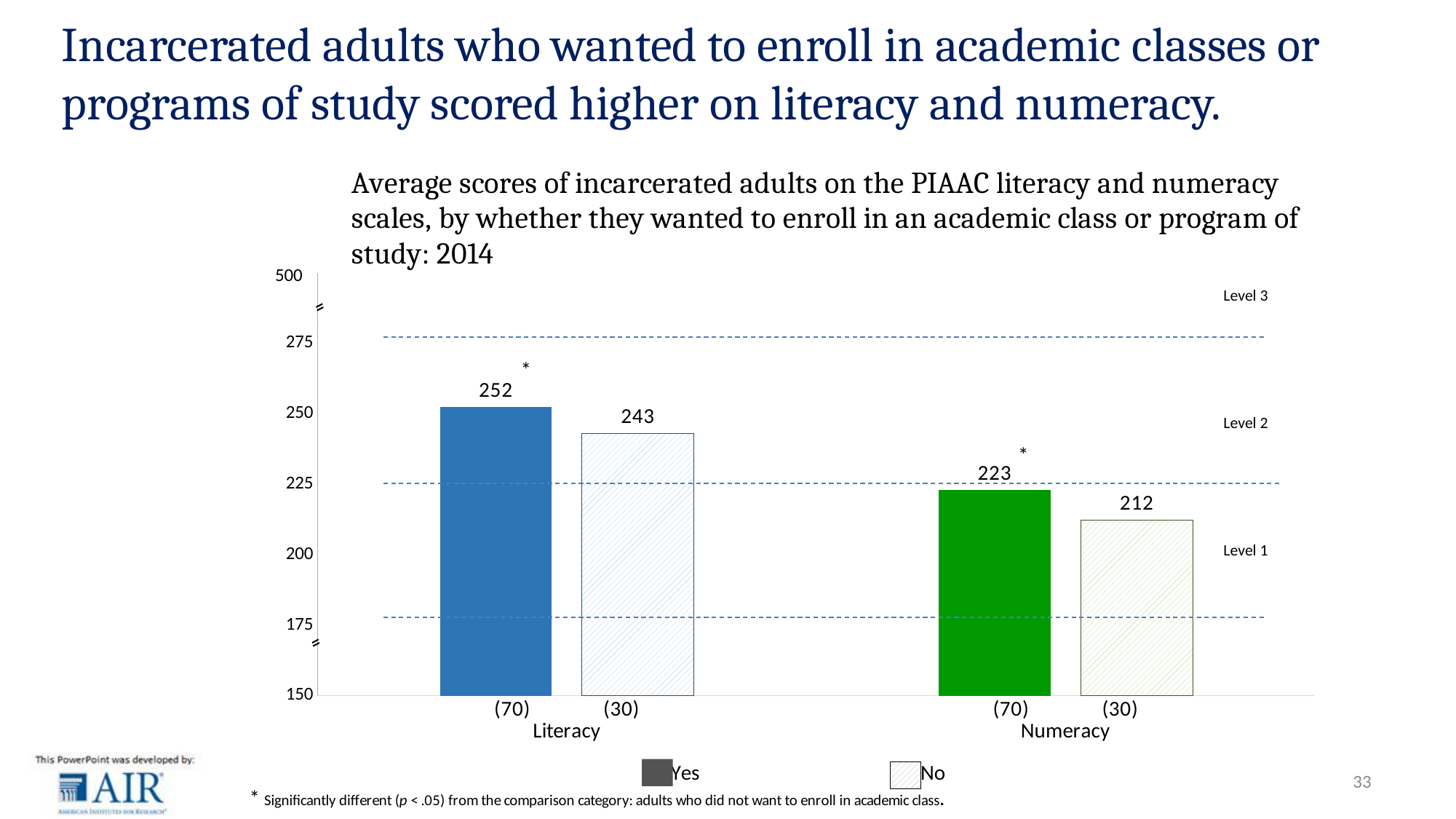
What kind of chart is shown on the slide? Bar chart What is the average literacy score for incarcerated adults who wanted to enroll in an academic class (Yes)? 252 What percentage of incarcerated adults is shown in parentheses for the Yes group? (70) What is the average numeracy score for incarcerated adults who did not want to enroll in an academic class (No)? 212 How many series does the legend list? 2 What is the difference between the literacy scores of the Yes and No groups? 9 What is the difference between the numeracy scores of the Yes and No groups? 11 What is the average literacy score for the No group? 243 What is the average numeracy score for the Yes group? 223 Which bar shows the highest average score on the chart? Literacy, Yes (252) Which bar shows the lowest average score on the chart? Numeracy, No (212) Which is larger: the numeracy score for the Yes group or the literacy score for the No group? Literacy score for the No group (243)